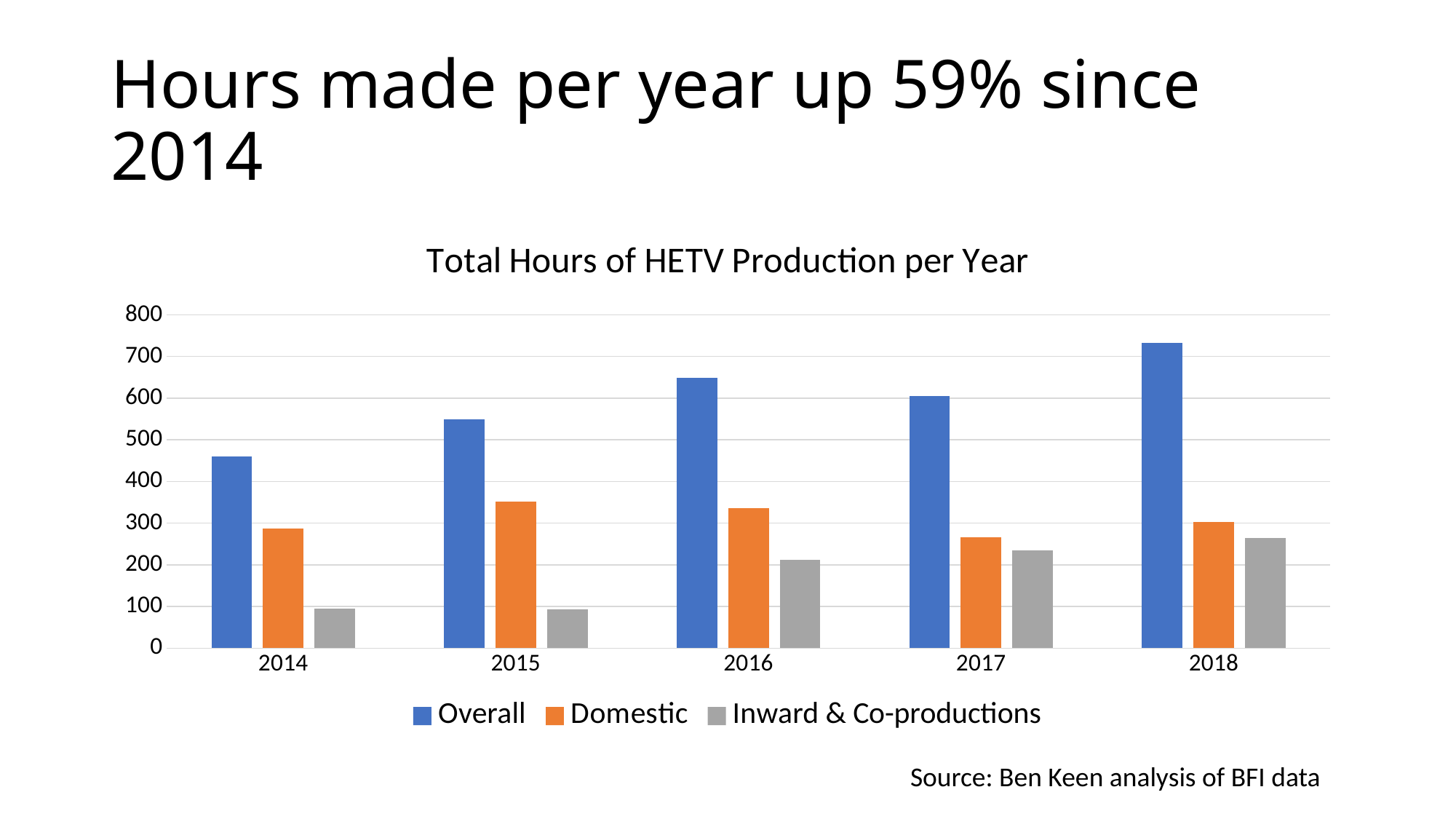
Which is larger, the Overall value for 2016 or the Overall value for 2017? 2016 How many years are shown on the x axis? 5 In which year is the Overall value highest? 2018 Is the Domestic value for 2015 greater or less than 300? greater Is the Inward & Co-productions value for 2014 greater or less than 200? less Do the Inward & Co-productions values rise or fall from 2016 to 2018? rise What is the title of the chart? Total Hours of HETV Production per Year Is the Overall value for 2014 greater or less than 500? less In which year is the Overall value lowest? 2014 What kind of chart is shown on the slide? Bar chart How many series does the legend list? 3